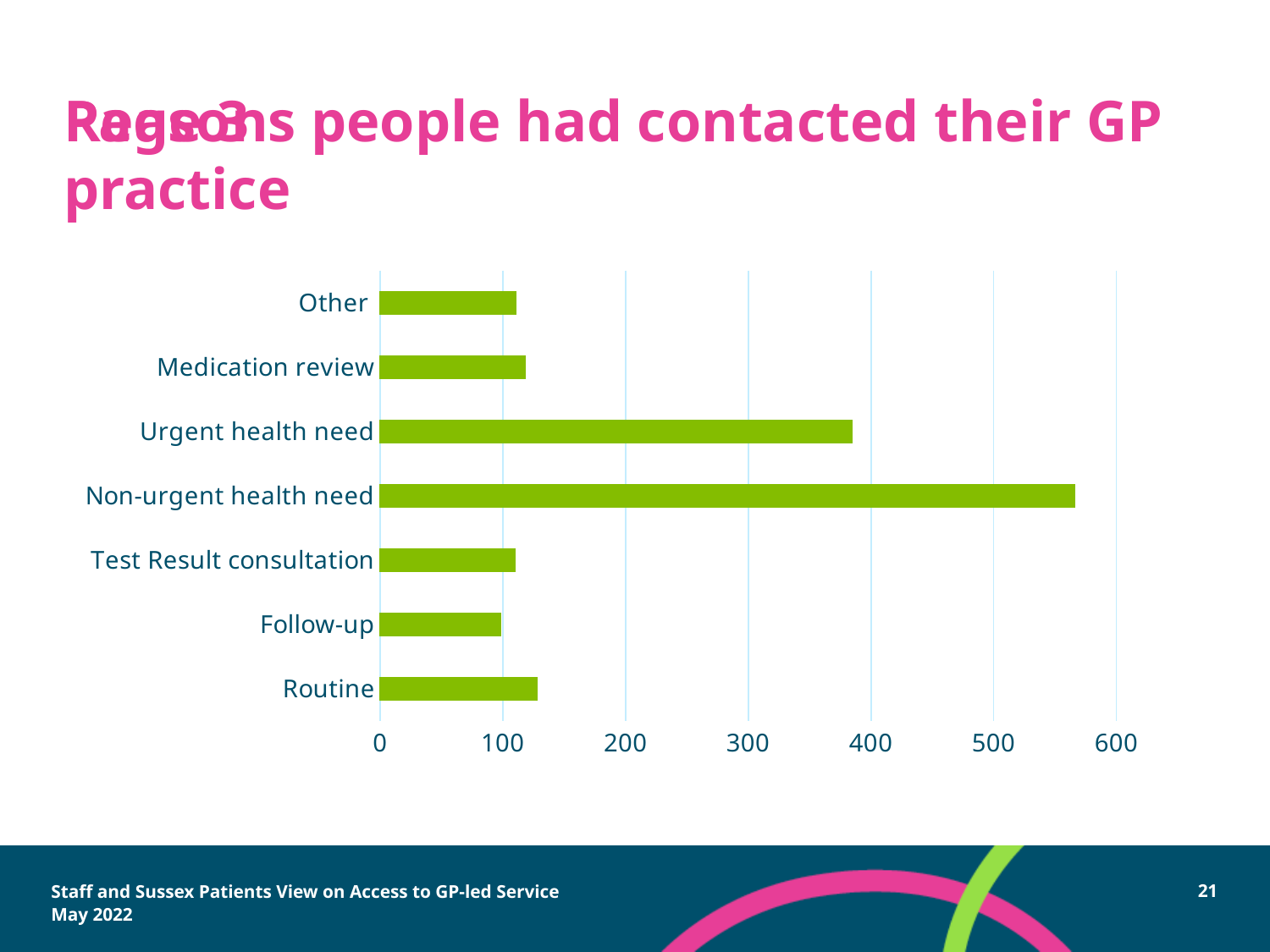
Which reason has the highest value in the chart? Non-urgent health need How many categories (reasons) are plotted in the chart? 7 What colour are the bars in the chart? green Is the value for Non-urgent health need greater or less than 500? greater What kind of chart is shown on the slide? bar chart Which is larger, the value for Non-urgent health need or the value for Urgent health need? Non-urgent health need Is the value for Urgent health need greater or less than 300? greater Which reason has the lowest value in the chart? Follow-up Is the value for Routine greater or less than 200? less Which is larger, the value for Urgent health need or the value for Medication review? Urgent health need